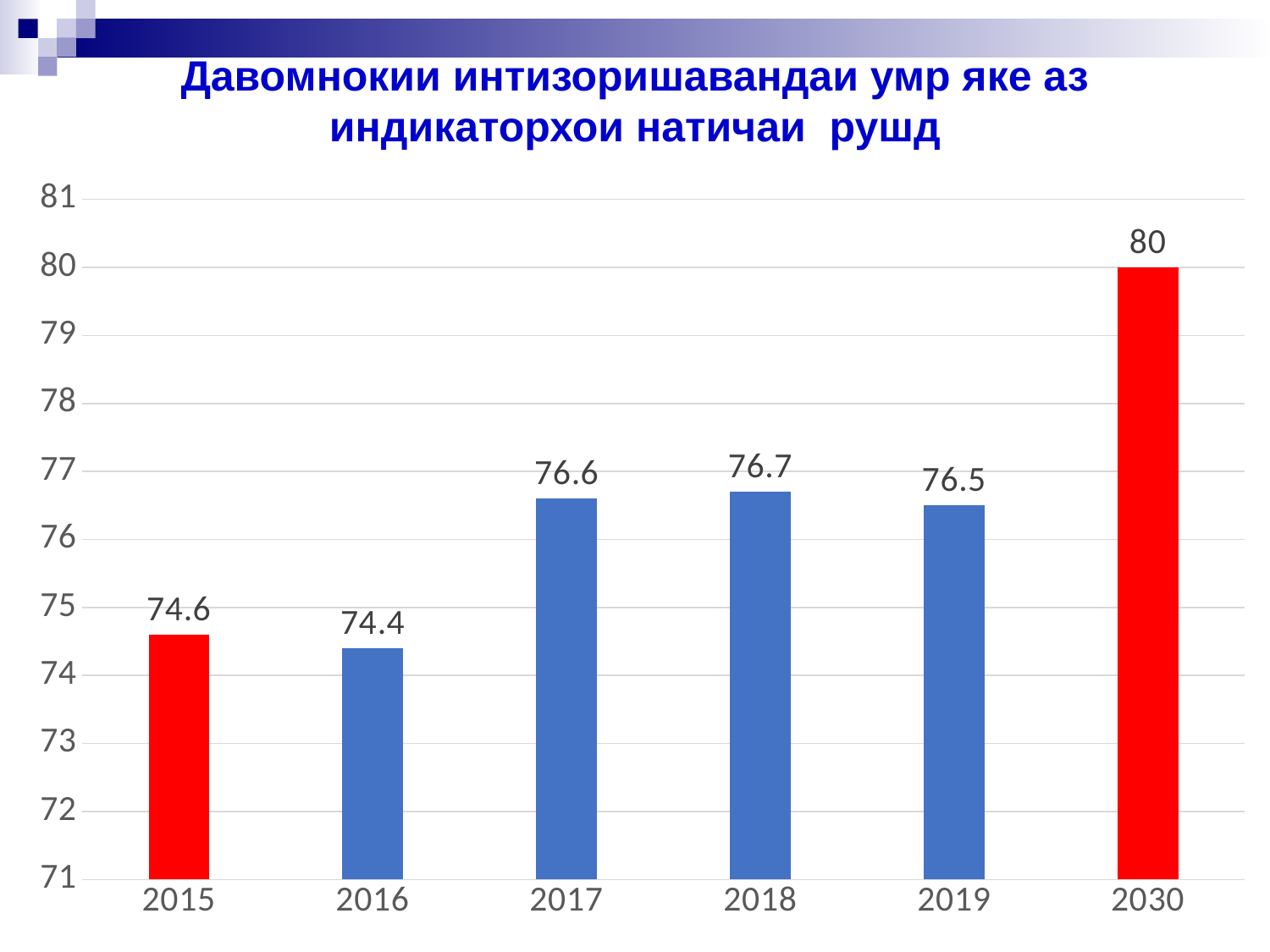
Which bars are coloured red? 2015 and 2030 How many years are shown on the x axis? 6 Which is larger, the value for 2015 or the value for 2016? 2015 Is the value for 2019 greater or less than 76? greater What kind of chart is this? bar chart What is the difference between the values for 2017 and 2016? 2.2 What is the value for 2015? 74.6 Which year has the lowest value? 2016 What is the value for 2030? 80 What is the value for 2018? 76.7 Which year has the highest value? 2030 What is the difference between the values for 2030 and 2019? 3.5